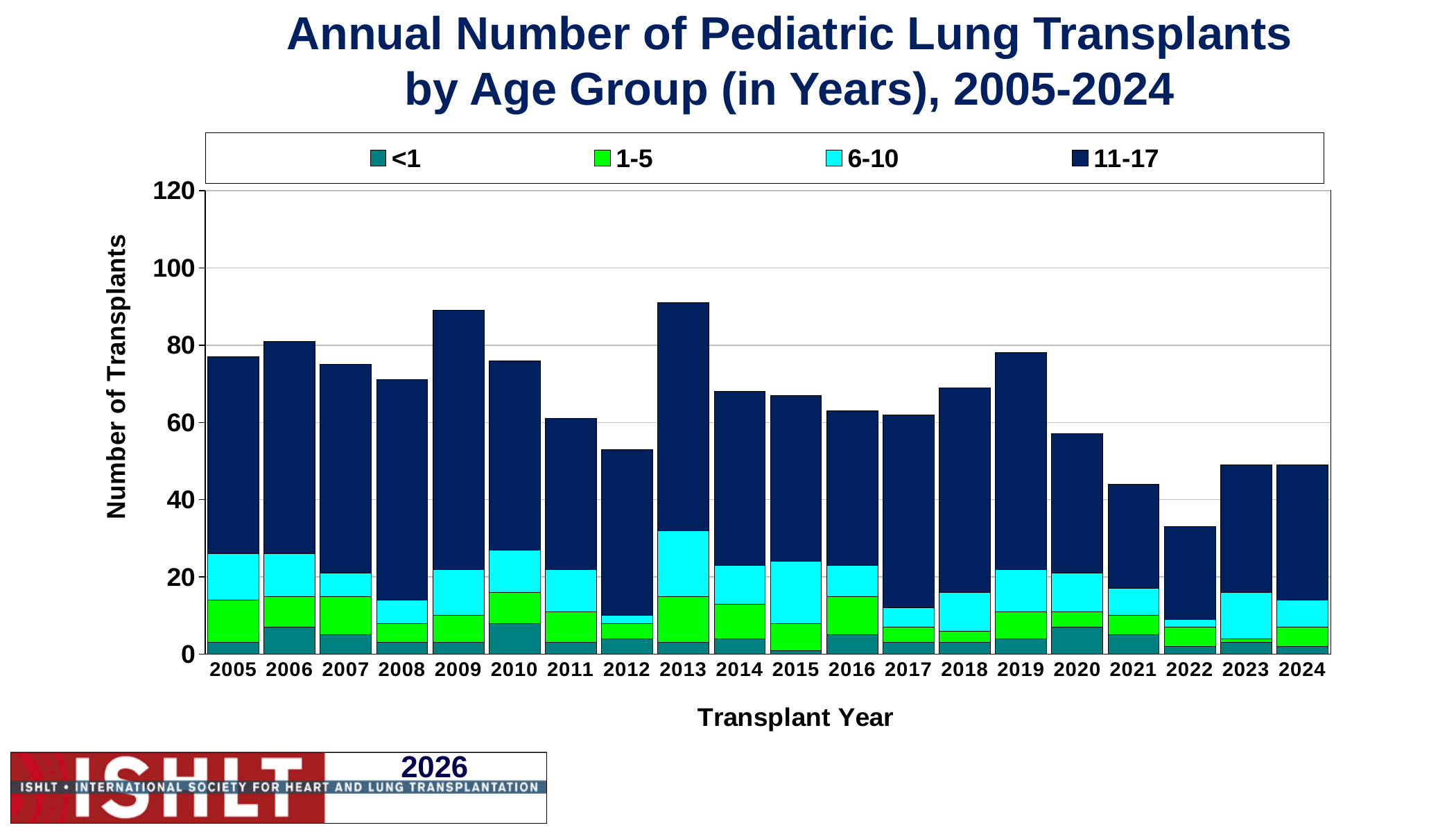
How many transplant years are shown on the x axis? 20 Is the total number of transplants in 2019 greater or less than 60? greater What kind of chart is shown on the slide? Stacked bar chart Which year has a larger total number of transplants, 2020 or 2021? 2020 Is the total number of transplants in 2012 greater or less than 60? less Is the total number of transplants in 2005 greater or less than 60? greater Which transplant year has the lowest total number of transplants? 2022 What is the label of the y axis? Number of Transplants Do the total numbers of transplants rise or fall from 2019 to 2022? fall How many age-group series does the legend list? 4 Which year has a larger total number of transplants, 2006 or 2008? 2006